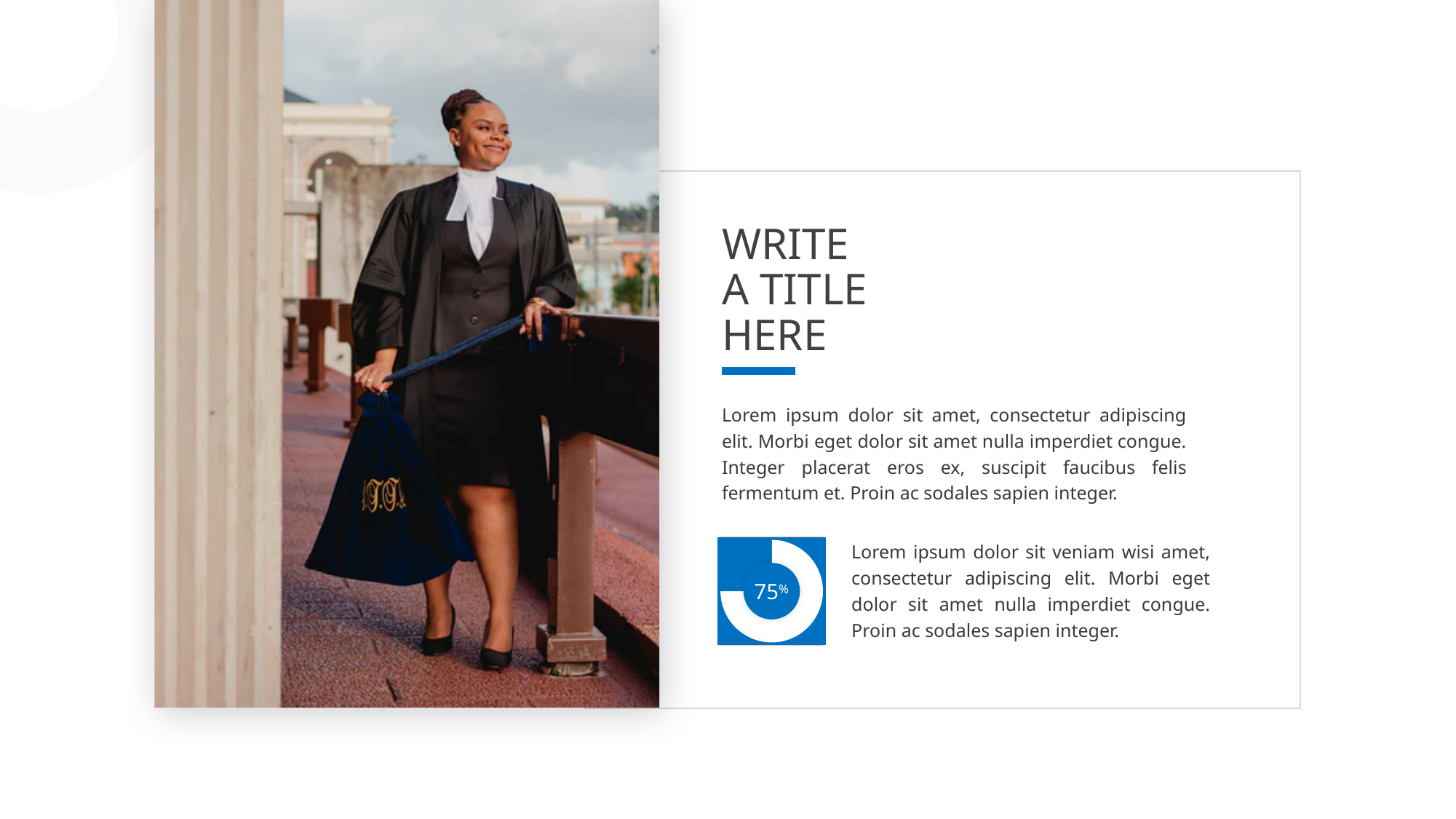
What percentage is printed in the centre of the donut chart? 75% What colour is the background square behind the donut chart? Blue What kind of chart is shown in the blue square on the slide? Donut chart What colour is the filled segment of the donut chart? White What share of the donut chart does the filled white segment represent? 75% Is the value shown in the donut chart greater or less than 50%? greater